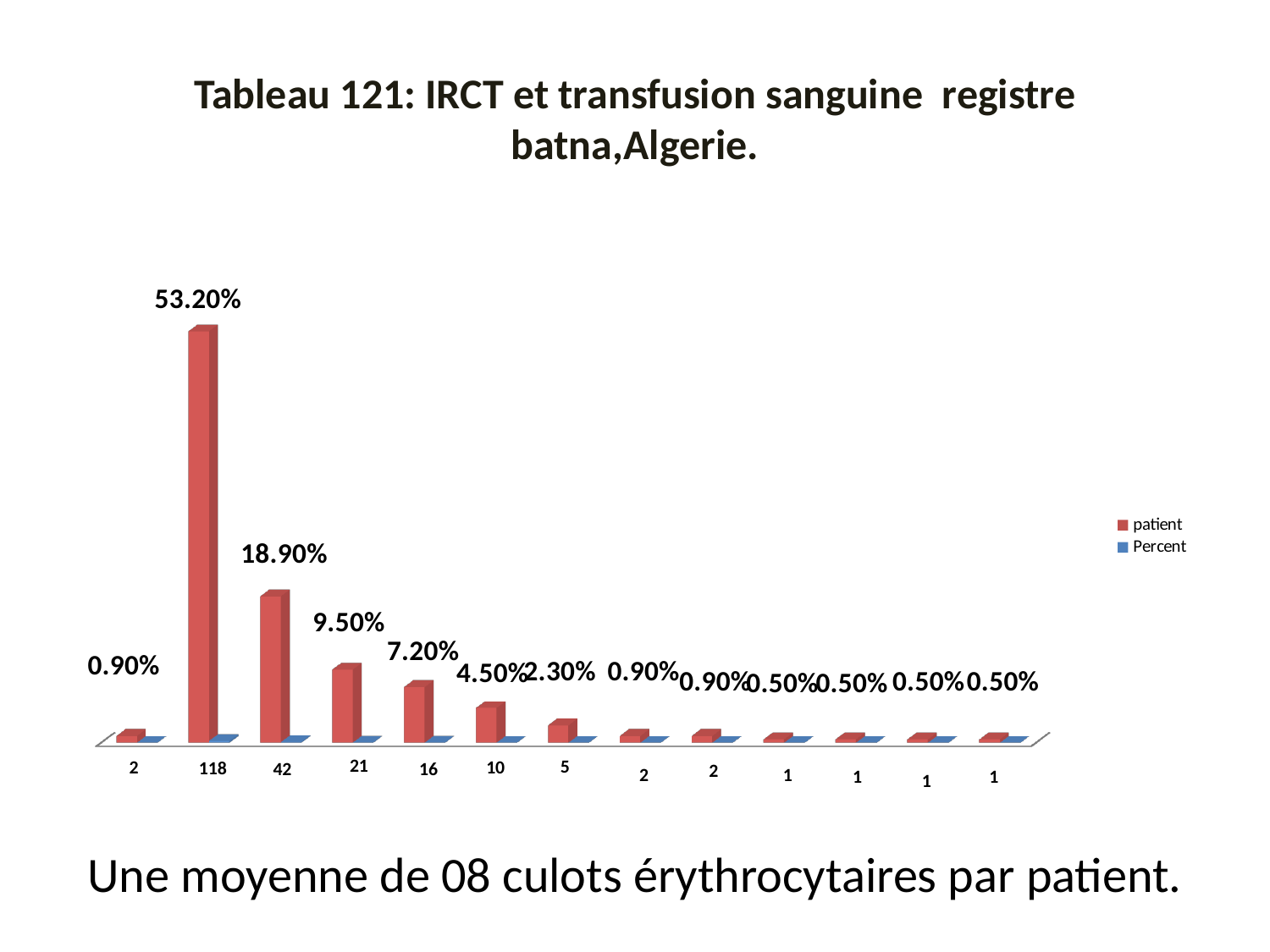
How many categories are shown along the x axis? 13 Which x-axis category has the tallest red bar? 118 What is the percentage label above the bar for the x-axis category 16? 7.20% What is the percentage label above the tallest bar? 53.20% Which has the larger percentage label, category 10 or category 5? 10 What are the two series names in the legend? patient, Percent What is the percentage label above the bar for the x-axis category 5? 2.30% What is the percentage label above the bar for the x-axis category 42? 18.90% What is the percentage label above the bar for the x-axis category 21? 9.50% What is the difference between the percentage labels for categories 118 and 42? 34.30% How many series does the legend list? 2 What kind of chart is shown on the slide? bar chart